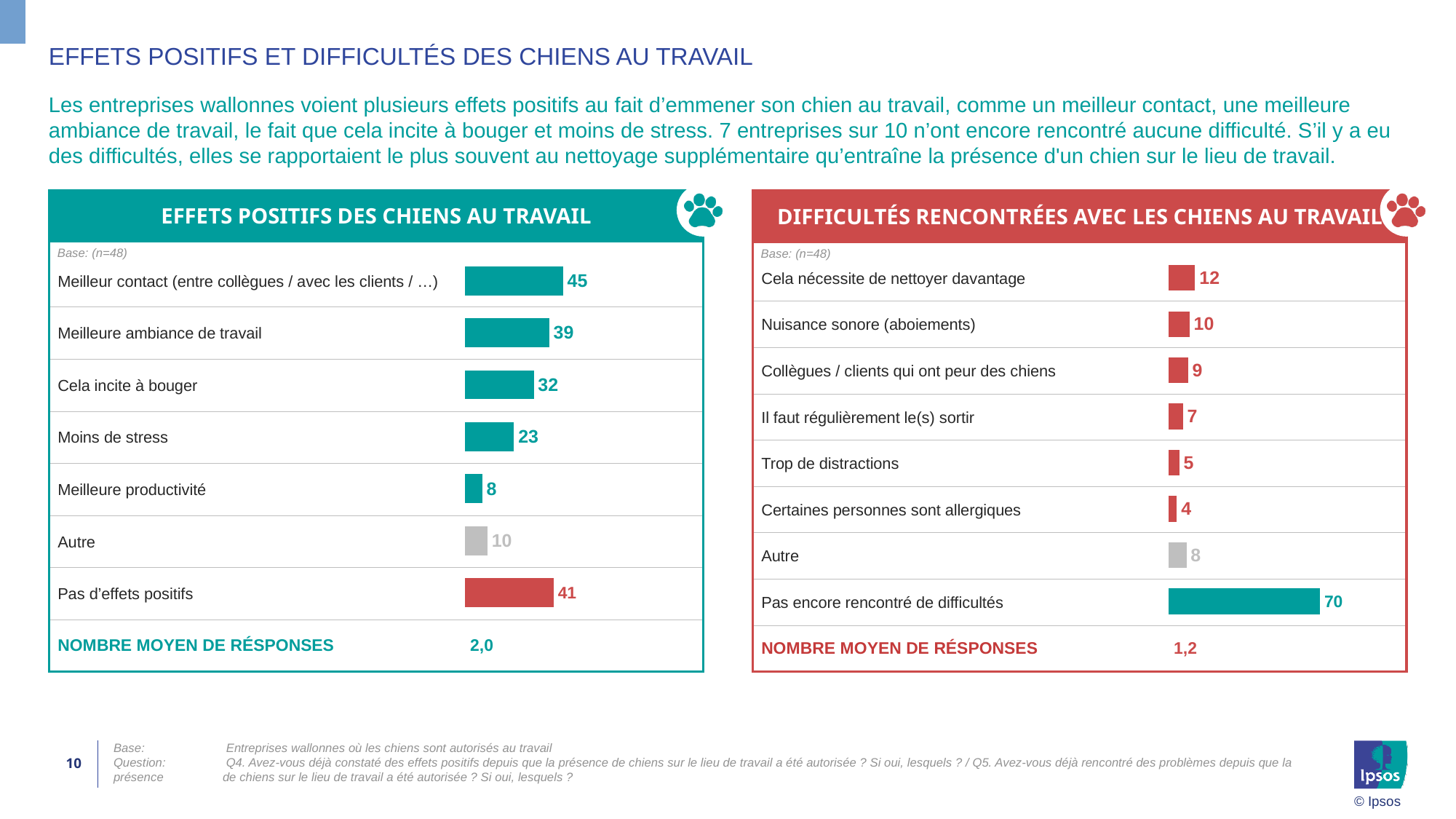
In the 'EFFETS POSITIFS DES CHIENS AU TRAVAIL' chart, what is the difference between 'Cela incite à bouger' and 'Moins de stress'? 9 In the 'DIFFICULTÉS RENCONTRÉES AVEC LES CHIENS AU TRAVAIL' chart, which category has the lowest value? Certaines personnes sont allergiques In the 'EFFETS POSITIFS DES CHIENS AU TRAVAIL' chart, which category has the highest value? Meilleur contact (entre collègues / avec les clients / …) In the 'DIFFICULTÉS RENCONTRÉES AVEC LES CHIENS AU TRAVAIL' chart, which is larger: 'Cela nécessite de nettoyer davantage' or 'Collègues / clients qui ont peur des chiens'? Cela nécessite de nettoyer davantage In the 'DIFFICULTÉS RENCONTRÉES AVEC LES CHIENS AU TRAVAIL' chart, which category has the highest value? Pas encore rencontré de difficultés In the 'EFFETS POSITIFS DES CHIENS AU TRAVAIL' chart, what is the 'NOMBRE MOYEN DE RÉPONSES'? 2,0 In the 'EFFETS POSITIFS DES CHIENS AU TRAVAIL' chart, what is the value for 'Meilleure ambiance de travail'? 39 In the 'EFFETS POSITIFS DES CHIENS AU TRAVAIL' chart, how many categories are shown? 7 In the 'EFFETS POSITIFS DES CHIENS AU TRAVAIL' chart, which category has the lowest value? Meilleure productivité What type of chart is used in the 'EFFETS POSITIFS DES CHIENS AU TRAVAIL' panel? Bar chart In the 'DIFFICULTÉS RENCONTRÉES AVEC LES CHIENS AU TRAVAIL' chart, how many categories are shown? 8 In the 'DIFFICULTÉS RENCONTRÉES AVEC LES CHIENS AU TRAVAIL' chart, what is the value for 'Nuisance sonore (aboiements)'? 10